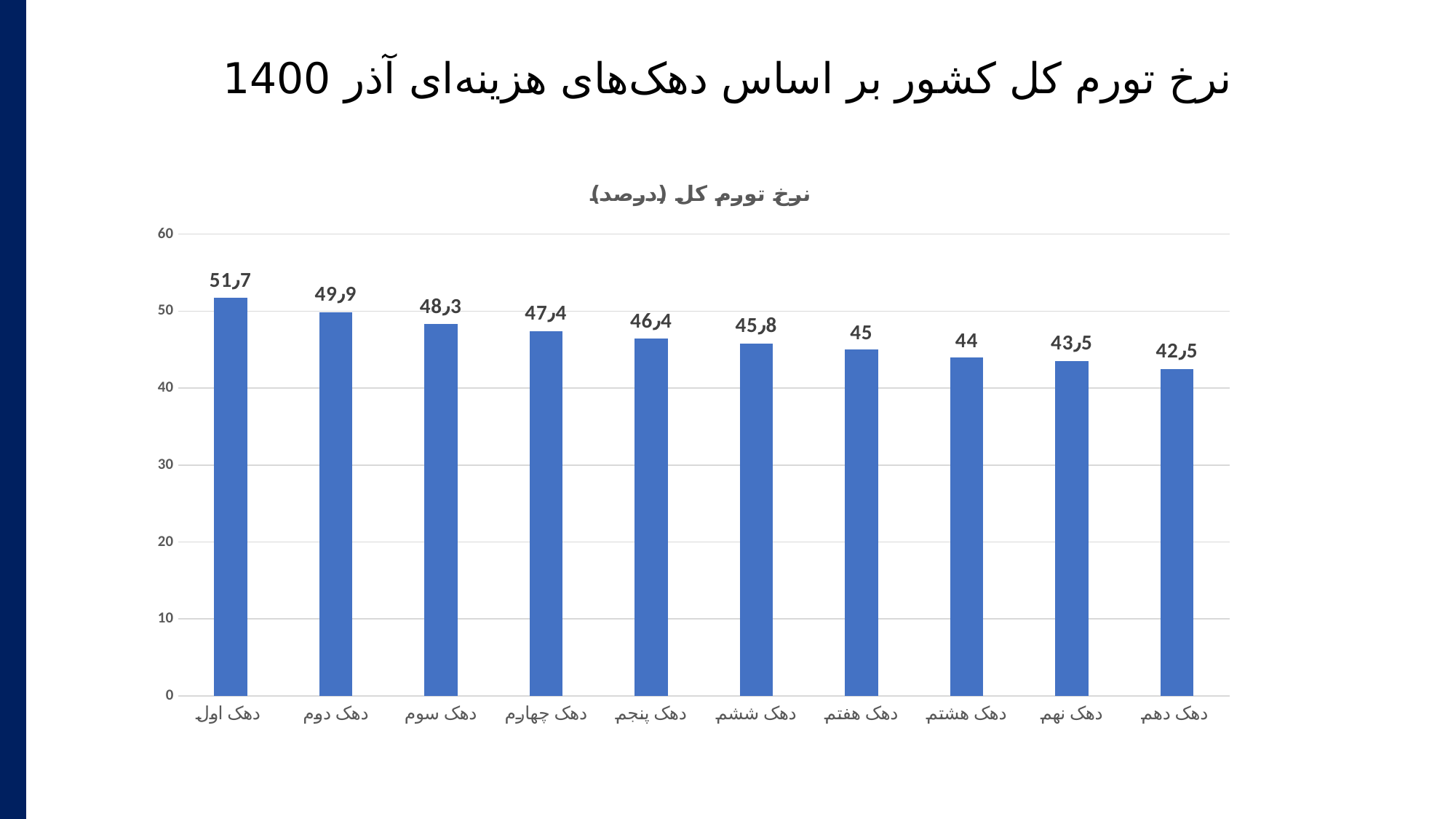
How many deciles (categories) are shown on the chart? 10 What kind of chart is shown on the slide? bar chart Is the value for دهک دوم greater or less than 40? greater Which decile has the highest inflation rate? دهک اول Which is larger, the value for دهک سوم or the value for دهک ششم? دهک سوم What is the value for دهک دهم (tenth decile)? 42٫5 What is the value for دهک اول (first decile)? 51٫7 Which decile has the lowest inflation rate? دهک دهم Do the values rise or fall from دهک اول to دهک دهم along the x axis? fall What is the difference between the values for دهک اول and دهک دهم? 9٫2 What is the title of the chart? نرخ تورم کل (درصد) What is the value for دهک هفتم (seventh decile)? 45